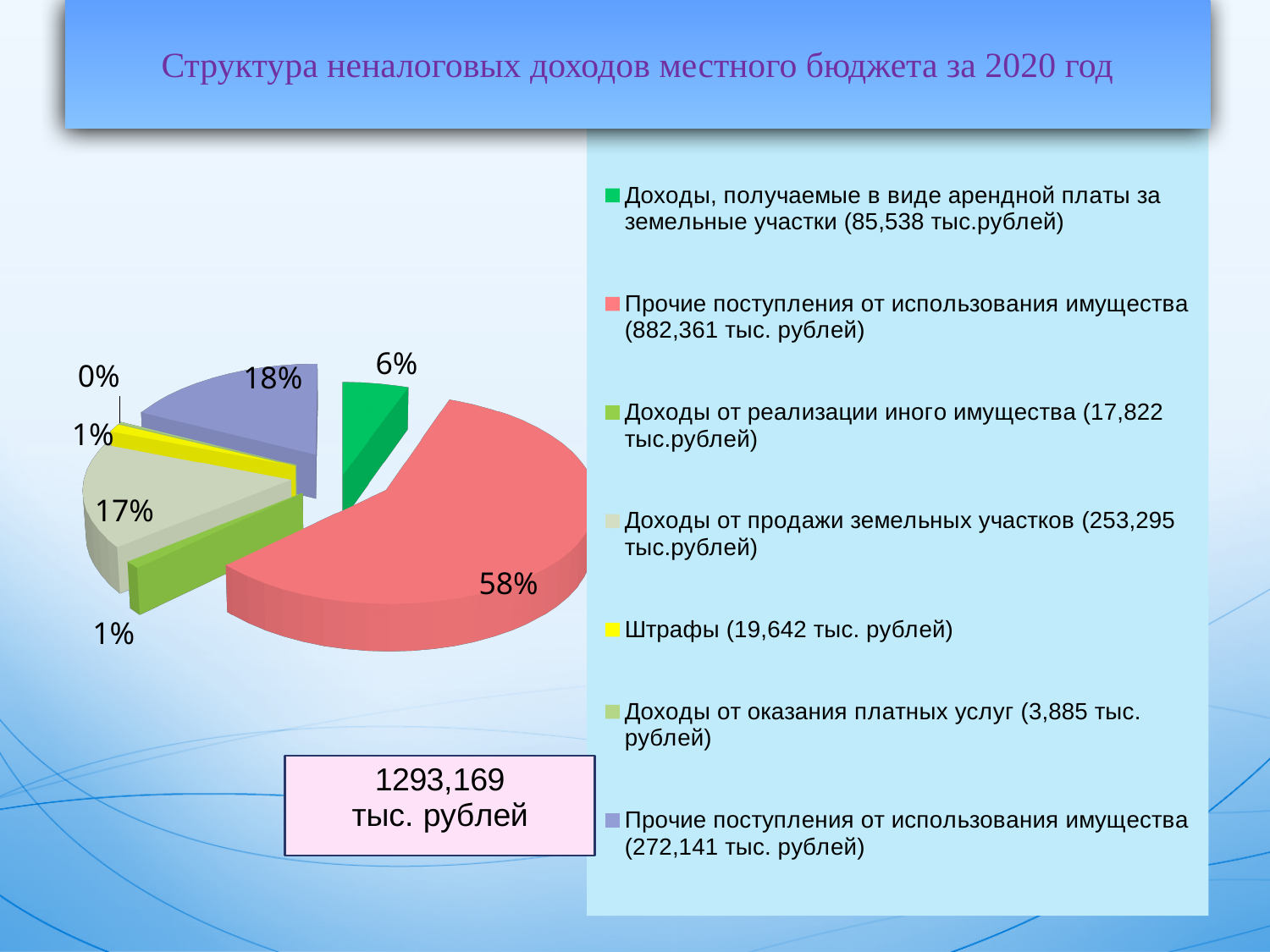
Which is larger: the share for "Доходы от продажи земельных участков" or the share for "Доходы, получаемые в виде арендной платы за земельные участки"? Доходы от продажи земельных участков How many categories does the legend list? 7 What is the difference in percentage points between the 58% slice and the 18% slice? 40 Which category has the largest slice of the pie? Прочие поступления от использования имущества (882,361 тыс. рублей) Which category has the smallest slice of the pie? Доходы от оказания платных услуг (3,885 тыс. рублей) What share of the pie does "Доходы, получаемые в виде арендной платы за земельные участки" have? 6% What kind of chart is shown on the slide? pie chart What total amount is shown in the box below the pie chart? 1293,169 тыс. рублей What share of the pie does "Доходы от оказания платных услуг" have? 0% What share of the pie does "Прочие поступления от использования имущества (882,361 тыс. рублей)" have? 58%